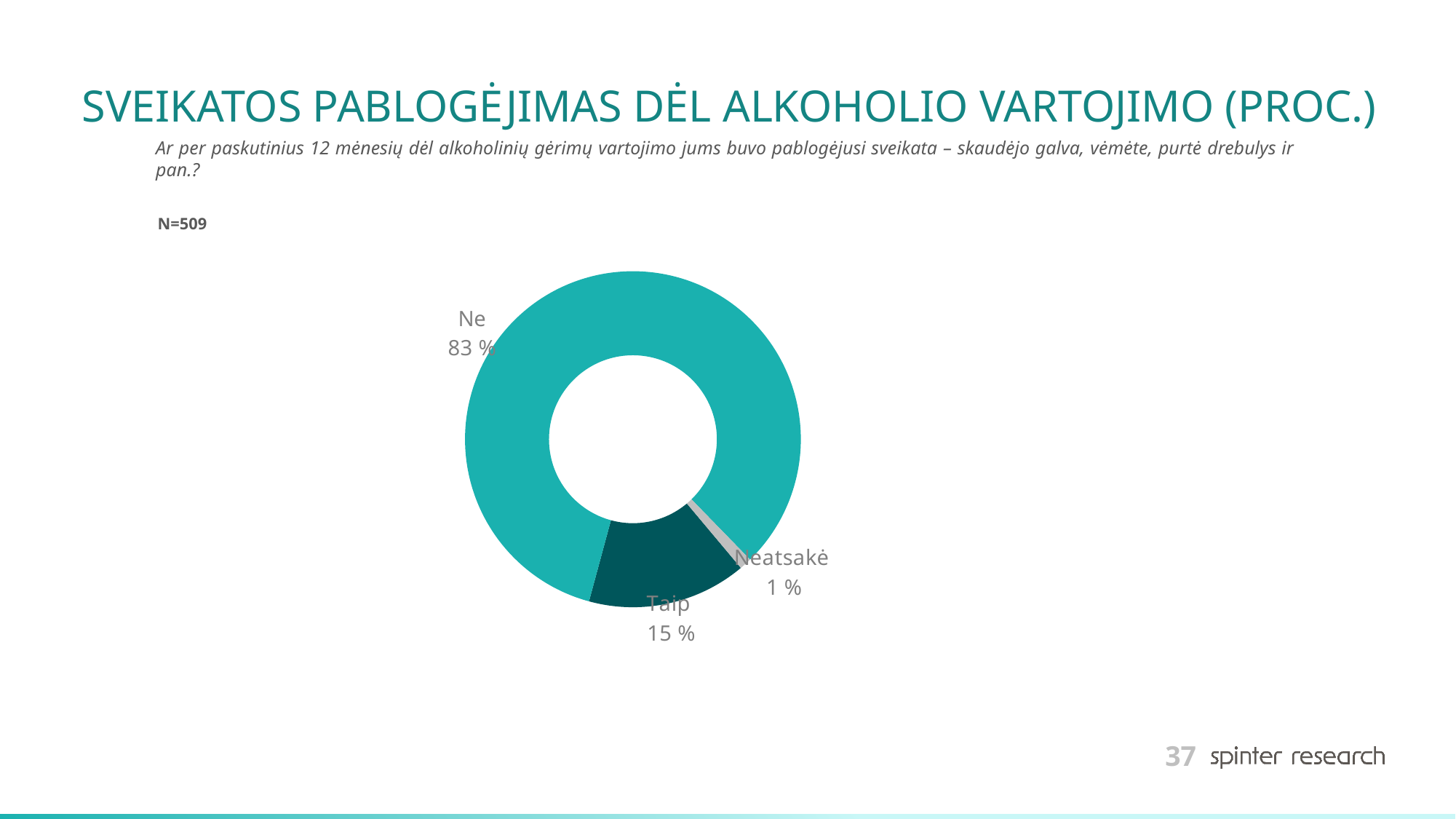
What is the difference in percentage points between "Ne" and "Taip"? 68 What percentage of respondents answered "Ne"? 83 % Which response category has the smallest share? Neatsakė How many categories are shown in the chart? 3 What kind of chart is shown on the slide? Pie chart (doughnut) What is the combined share of "Taip" and "Neatsakė"? 16 % Which response category has the largest share? Ne What percentage of respondents answered "Taip"? 15 % What is the sample size (N) stated on the slide? N=509 Which is larger, the share for "Taip" or the share for "Neatsakė"? Taip What percentage of respondents answered "Neatsakė"? 1 % What is the title of the slide? SVEIKATOS PABLOGĖJIMAS DĖL ALKOHOLIO VARTOJIMO (PROC.)